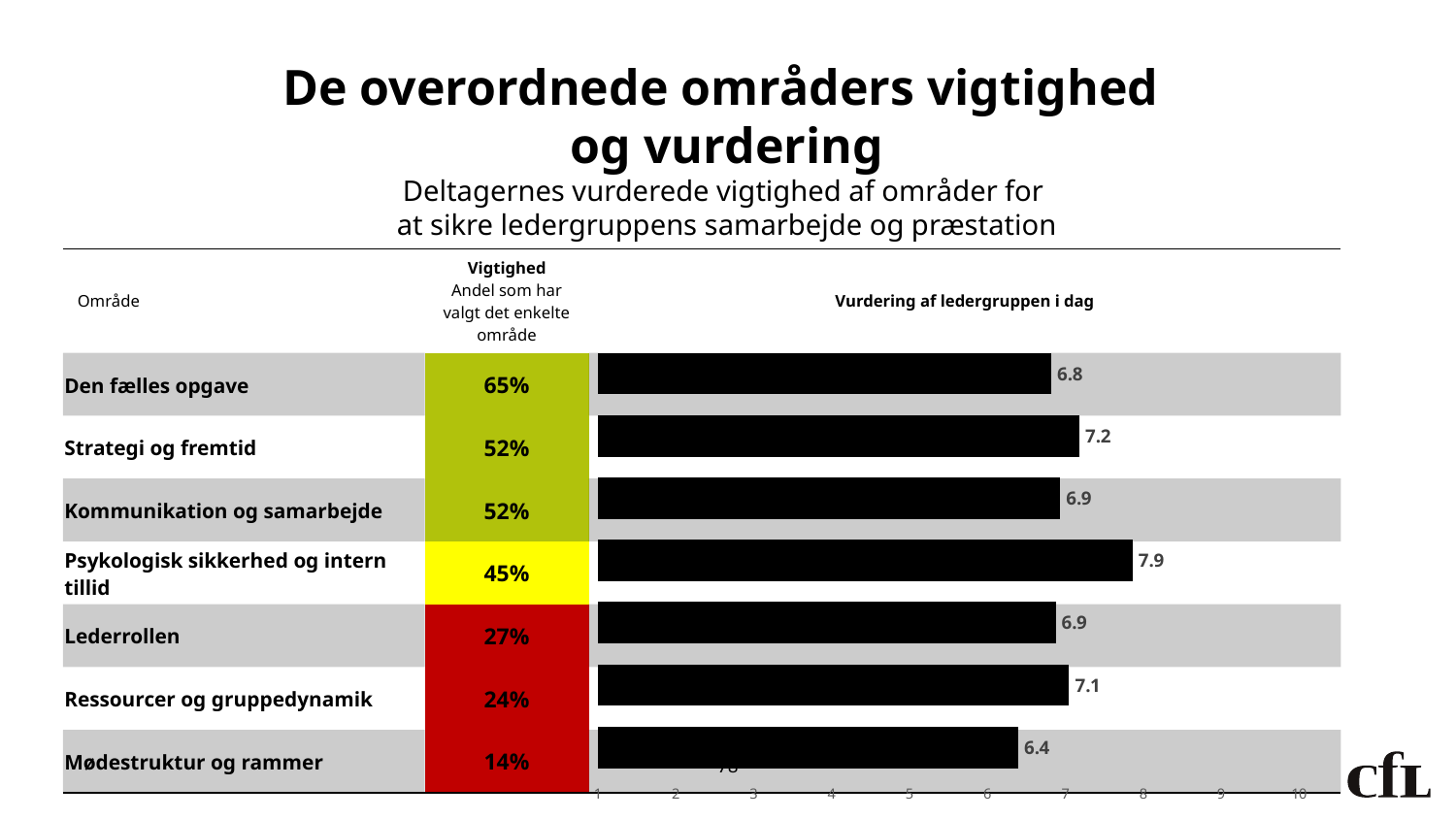
What is the value for Mødestruktur og rammer in the Vurdering af ledergruppen i dag chart? 6.4 In the Vurdering af ledergruppen i dag chart, is the value for Mødestruktur og rammer greater or less than 7? less What is the value for Psykologisk sikkerhed og intern tillid in the Vurdering af ledergruppen i dag chart? 7.9 What is the value for Ressourcer og gruppedynamik in the Vurdering af ledergruppen i dag chart? 7.1 What is the title of the chart on the slide? Vurdering af ledergruppen i dag What kind of chart is the Vurdering af ledergruppen i dag chart? bar chart Which category has the lowest value in the Vurdering af ledergruppen i dag chart? Mødestruktur og rammer In the Vurdering af ledergruppen i dag chart, which has the larger value: Strategi og fremtid or Den fælles opgave? Strategi og fremtid Which category has the highest value in the Vurdering af ledergruppen i dag chart? Psykologisk sikkerhed og intern tillid What is the difference between the values for Strategi og fremtid and Den fælles opgave in the Vurdering af ledergruppen i dag chart? 0.4 What is the difference between the values for Psykologisk sikkerhed og intern tillid and Mødestruktur og rammer in the Vurdering af ledergruppen i dag chart? 1.5 How many categories are shown in the Vurdering af ledergruppen i dag chart? 7